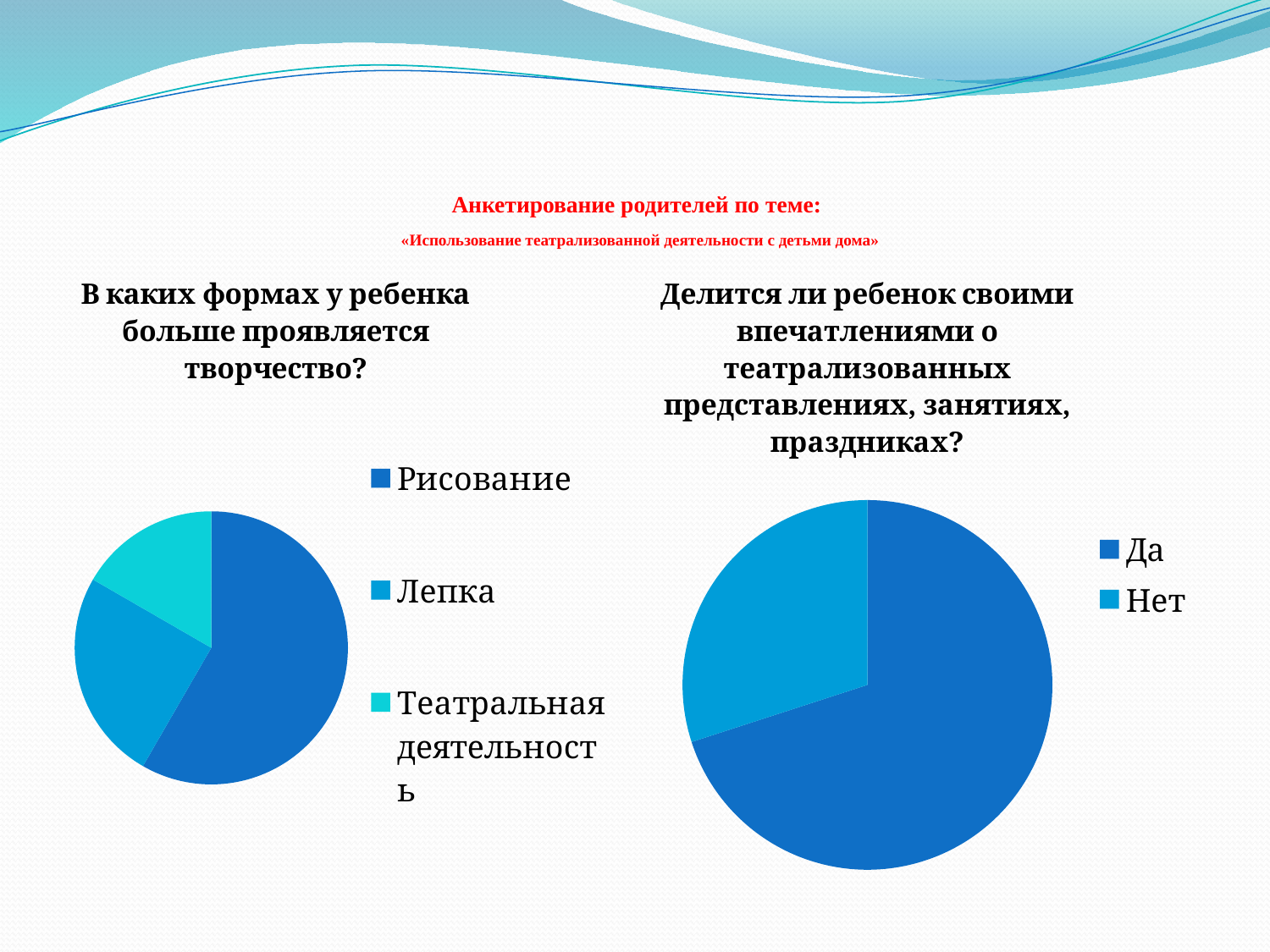
In the left chart «В каких формах у ребенка больше проявляется творчество?», which category has the smallest slice? Театральная деятельность What kind of chart is the right chart titled «Делится ли ребенок своими впечатлениями о театрализованных представлениях, занятиях, праздниках?»? pie chart In the left chart «В каких формах у ребенка больше проявляется творчество?», which category has the largest slice? Рисование What kind of chart is the left chart titled «В каких формах у ребенка больше проявляется творчество?»? pie chart In the left chart «В каких формах у ребенка больше проявляется творчество?», which slice is larger: Лепка or Театральная деятельность? Лепка In the left chart «В каких формах у ребенка больше проявляется творчество?», how many slices does the pie have? 3 How many entries does the legend of the left chart «В каких формах у ребенка больше проявляется творчество?» list? 3 In the right chart «Делится ли ребенок своими впечатлениями...», how many slices does the pie have? 2 How many entries does the legend of the right chart «Делится ли ребенок своими впечатлениями...» list? 2 What are the legend entries of the right chart «Делится ли ребенок своими впечатлениями...»? Да, Нет In the right chart «Делится ли ребенок своими впечатлениями...», which slice is smaller: Да or Нет? Нет In the right chart «Делится ли ребенок своими впечатлениями...», which answer has the larger slice? Да